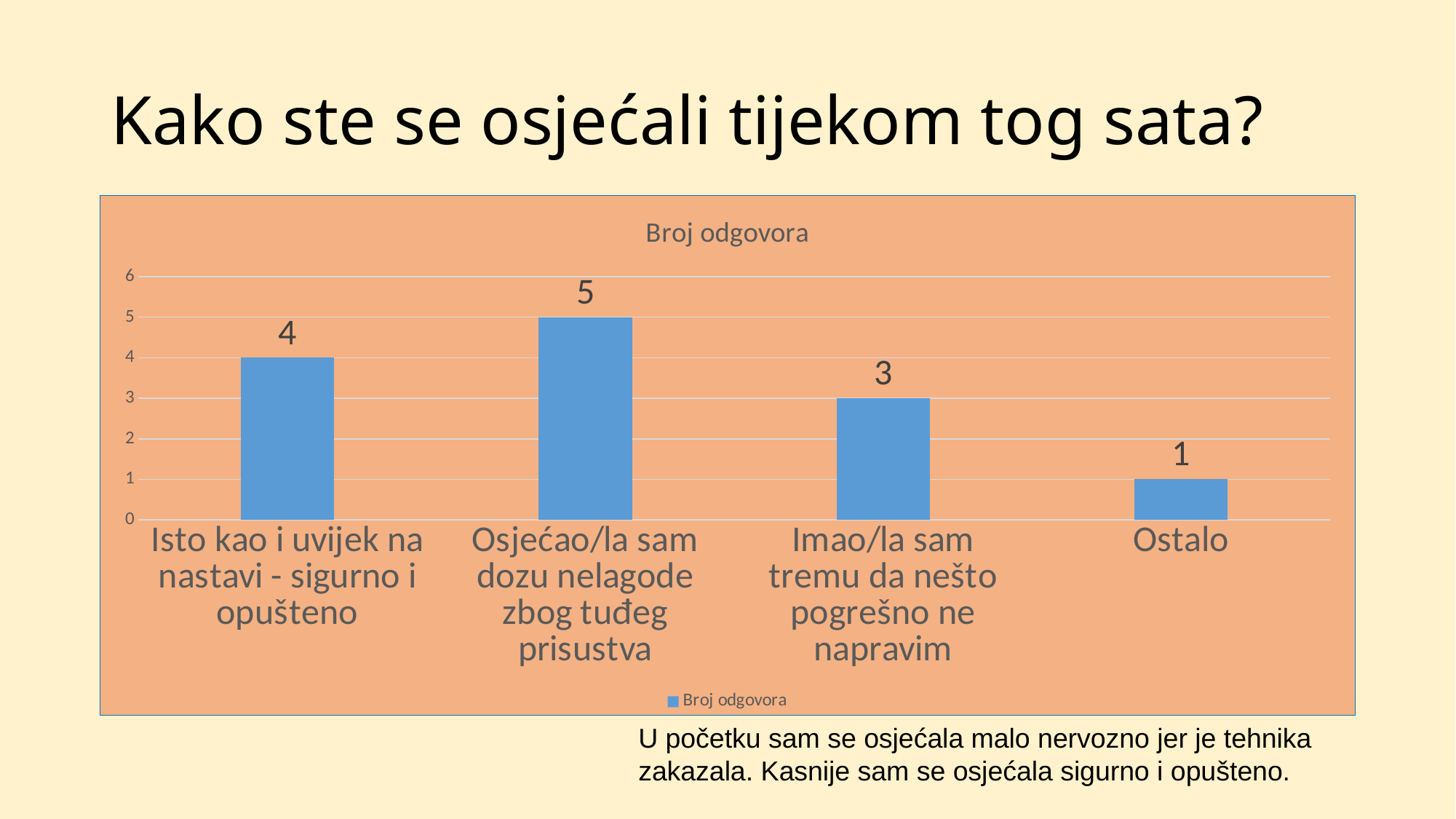
What is the value for "Ostalo"? 1 What is the value for "Imao/la sam tremu da nešto pogrešno ne napravim"? 3 What kind of chart is shown? bar chart Which category has the lowest value? Ostalo What is the value for "Osjećao/la sam dozu nelagode zbog tuđeg prisustva"? 5 Is the value for "Imao/la sam tremu da nešto pogrešno ne napravim" greater or less than 4? less How many series does the legend list? 1 Which is larger: the value for "Isto kao i uvijek na nastavi - sigurno i opušteno" or the value for "Imao/la sam tremu da nešto pogrešno ne napravim"? Isto kao i uvijek na nastavi - sigurno i opušteno Which category has the highest value? Osjećao/la sam dozu nelagode zbog tuđeg prisustva What is the difference between the values for "Osjećao/la sam dozu nelagode zbog tuđeg prisustva" and "Isto kao i uvijek na nastavi - sigurno i opušteno"? 1 What is the title of the chart? Broj odgovora How many categories are shown on the x axis? 4